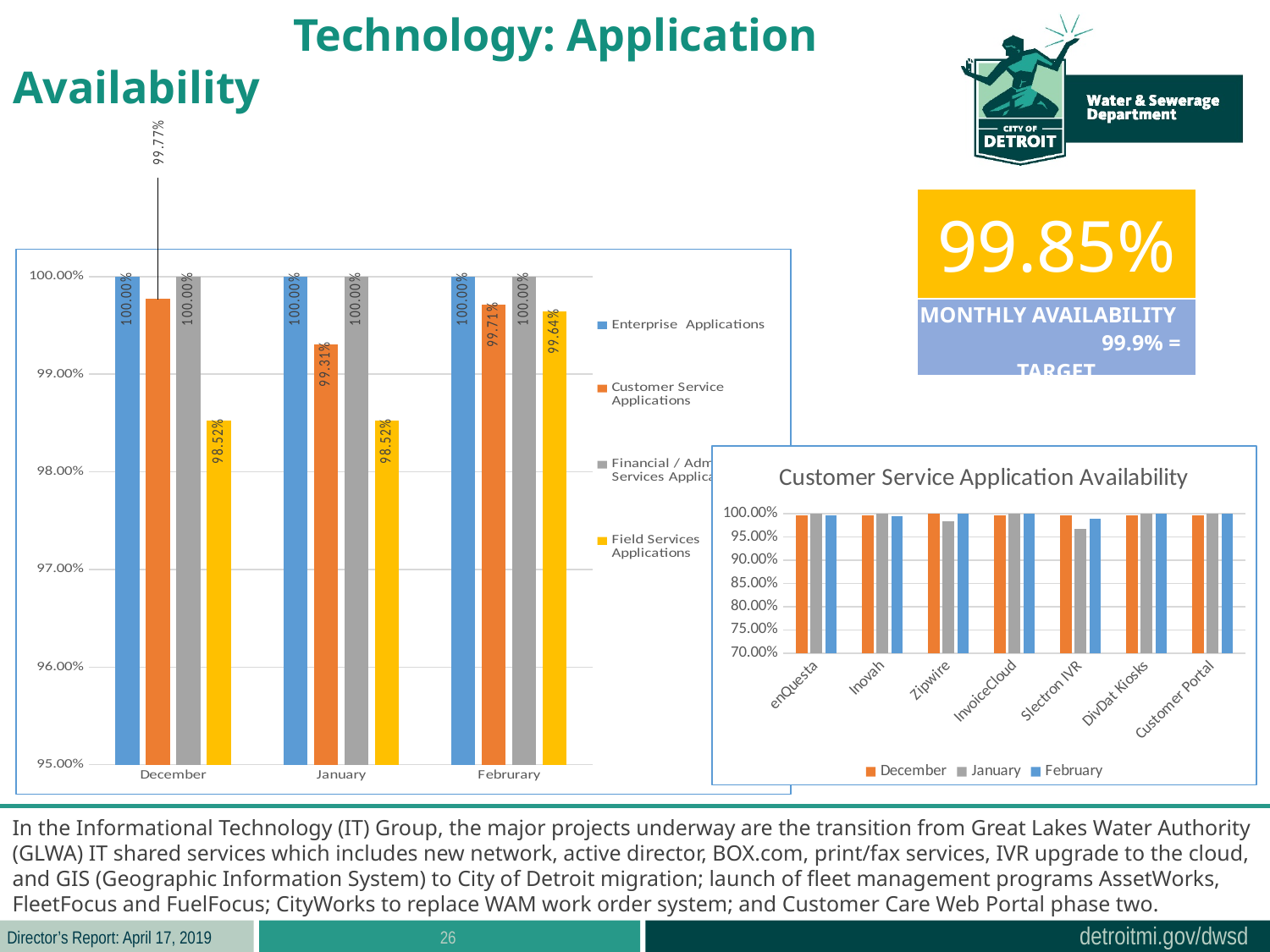
In the 'Customer Service Application Availability' chart, how many series does the legend list? 3 In the left chart, what is the value for Customer Service Applications in December? 99.77% In the left chart, what is the value for Field Services Applications in February? 99.64% In the left chart, which series has the lowest value in January? Field Services Applications In the 'Customer Service Application Availability' chart, which category has the lowest January value? Slectron IVR In the left chart, what is the difference between the Customer Service Applications values for February and January? 0.40% In the left chart, what is the value for Customer Service Applications in February? 99.71% In the left chart, what is the value for Field Services Applications in December? 98.52% In the left chart, what is the value for Customer Service Applications in January? 99.31% In the left chart, which is larger: Customer Service Applications in December or in January? December What kind of chart is the left chart on the slide? bar chart How many series does the legend of the left chart list? 4